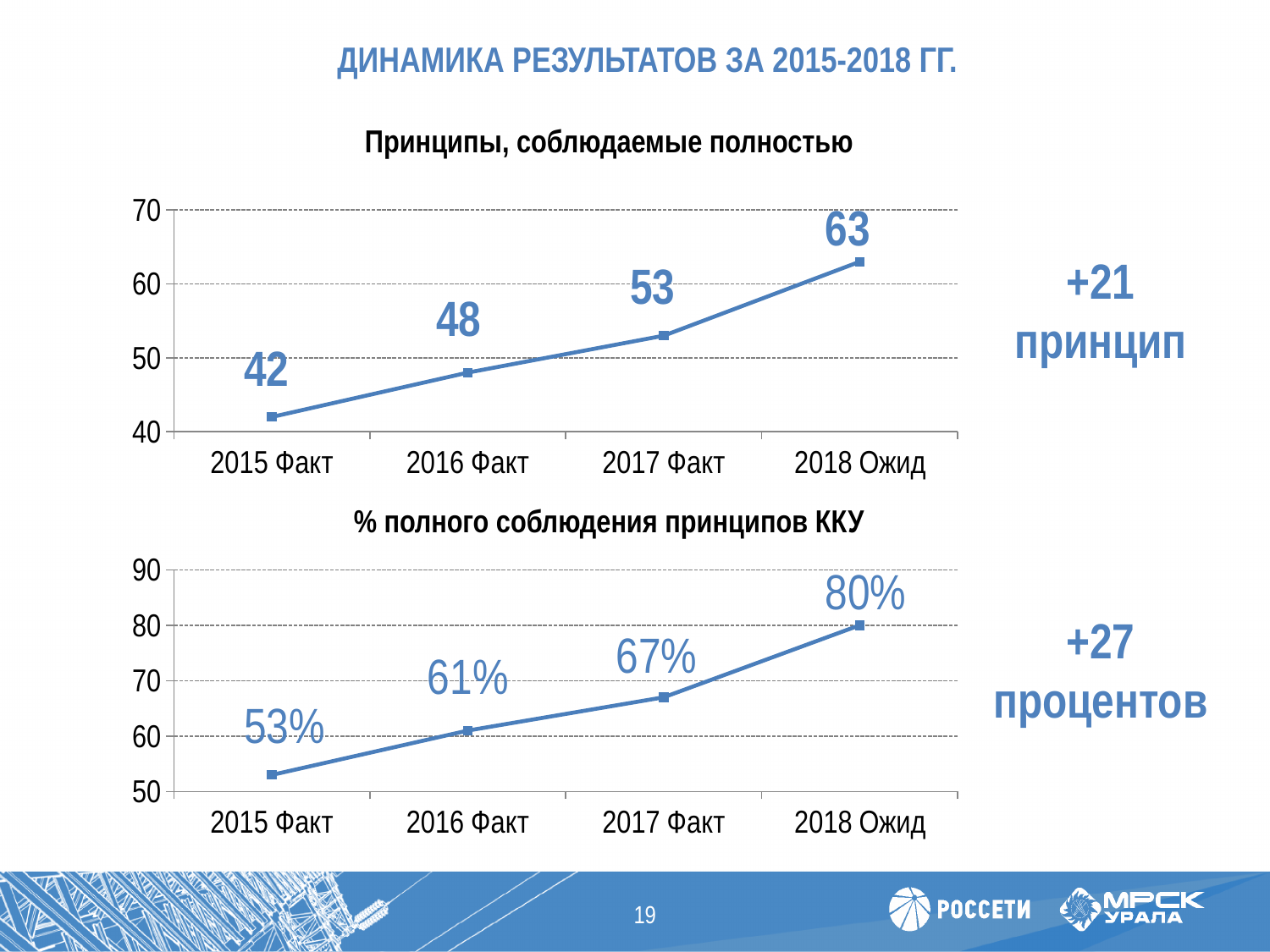
In the bottom chart '% полного соблюдения принципов ККУ', what is the value for 2017 Факт? 67% What type of chart is the top chart 'Принципы, соблюдаемые полностью'? Line chart In the bottom chart '% полного соблюдения принципов ККУ', what is the difference between the 2018 Ожид and 2016 Факт values? 19% In the top chart 'Принципы, соблюдаемые полностью', what is the difference between the 2018 Ожид and 2015 Факт values? 21 In the top chart 'Принципы, соблюдаемые полностью', which category has the lowest value? 2015 Факт In the top chart 'Принципы, соблюдаемые полностью', which is larger: the value for 2017 Факт or 2016 Факт? 2017 Факт In the top chart 'Принципы, соблюдаемые полностью', what is the value for 2016 Факт? 48 How many data points are plotted in the bottom chart '% полного соблюдения принципов ККУ'? 4 In the bottom chart '% полного соблюдения принципов ККУ', which category has the highest value? 2018 Ожид In the bottom chart '% полного соблюдения принципов ККУ', what is the value for 2015 Факт? 53% In the top chart 'Принципы, соблюдаемые полностью', what is the value for 2018 Ожид? 63 In the bottom chart '% полного соблюдения принципов ККУ', do the values rise or fall from 2015 Факт to 2018 Ожид? Rise